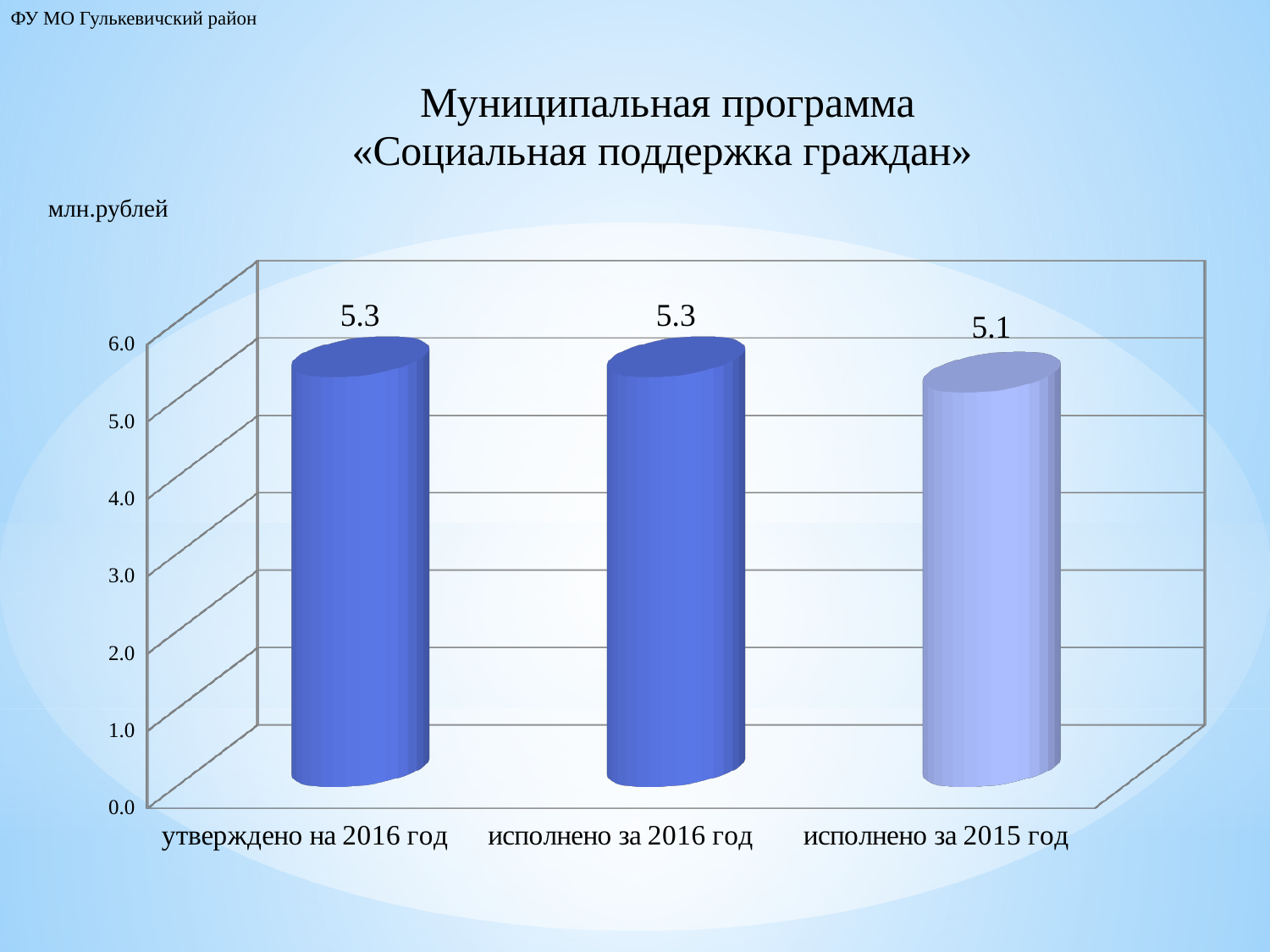
How many categories are shown on the chart? 3 What kind of chart is shown on the slide? bar chart What is the value for «исполнено за 2016 год»? 5.3 What is the difference between the value for «исполнено за 2016 год» and the value for «исполнено за 2015 год»? 0.2 Is the value for «утверждено на 2016 год» greater or less than 5.0? greater Is the value for «исполнено за 2015 год» greater or less than 6.0? less Which is larger: the value for «утверждено на 2016 год» or the value for «исполнено за 2015 год»? утверждено на 2016 год What unit of measurement is indicated above the chart? млн.рублей Which category has the lowest value? исполнено за 2015 год What is the value for «исполнено за 2015 год»? 5.1 What is the title of the chart? Муниципальная программа «Социальная поддержка граждан» What is the value for «утверждено на 2016 год»? 5.3